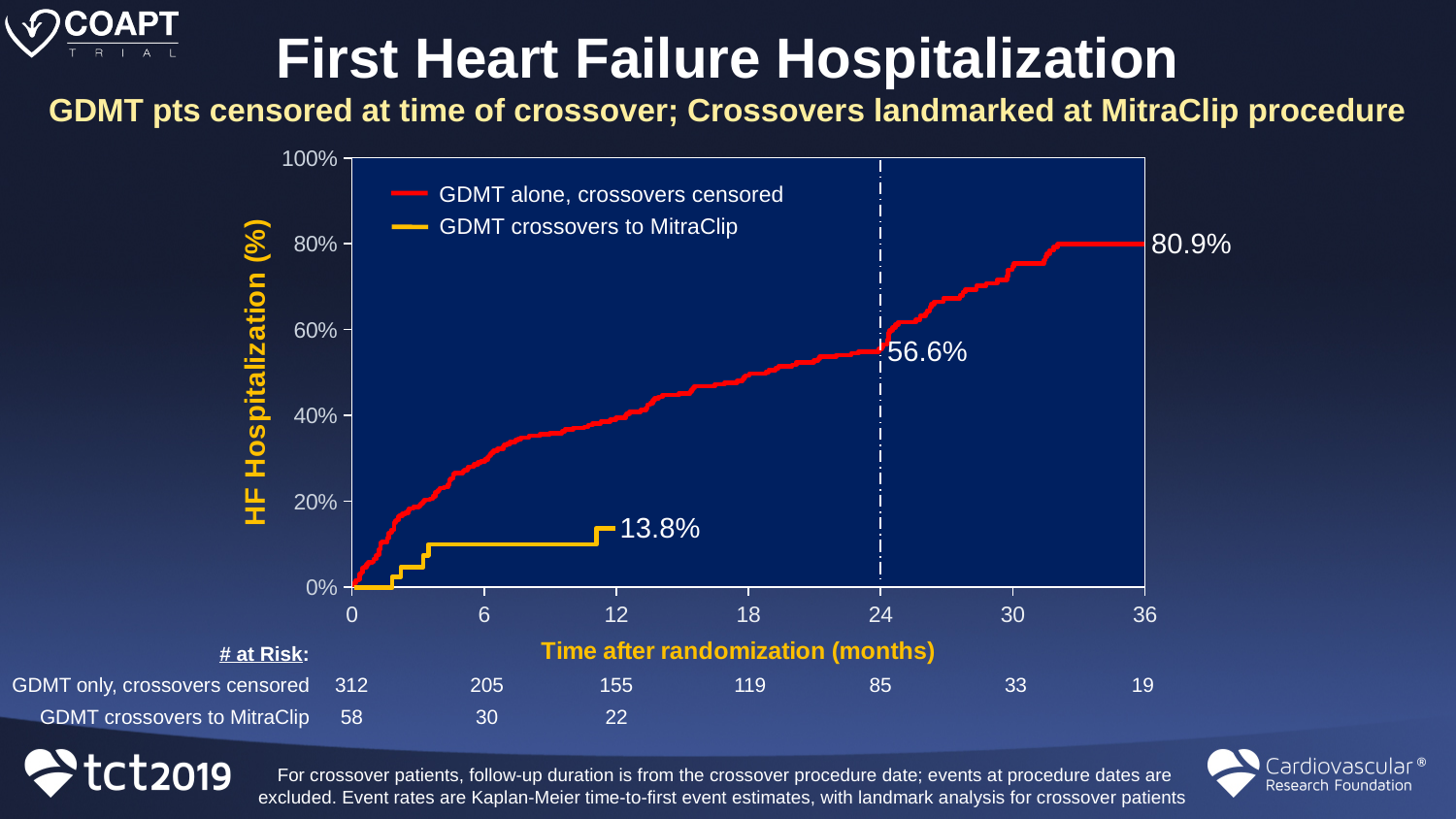
What is the HF hospitalization rate for GDMT alone, crossovers censored, at 36 months? 80.9% What is the final labeled HF hospitalization rate for GDMT crossovers to MitraClip? 13.8% What kind of chart is shown on the slide? Line chart (Kaplan-Meier curve) Which series reaches the higher HF hospitalization rate, GDMT alone or GDMT crossovers to MitraClip? GDMT alone, crossovers censored What is the label of the y-axis? HF Hospitalization (%) What is the HF hospitalization rate for GDMT alone, crossovers censored, at 24 months (the dashed line)? 56.6% Does the GDMT alone, crossovers censored curve rise or fall over time after randomization? Rise How many patients were at risk in the GDMT crossovers to MitraClip group at 12 months? 22 Is the HF hospitalization rate for GDMT alone at 12 months greater or less than 60%? less How many series does the legend list? 2 How many patients were at risk in the GDMT only, crossovers censored group at 0 months? 312 What is the difference between the GDMT alone rate at 36 months (80.9%) and at 24 months (56.6%)? 24.3%